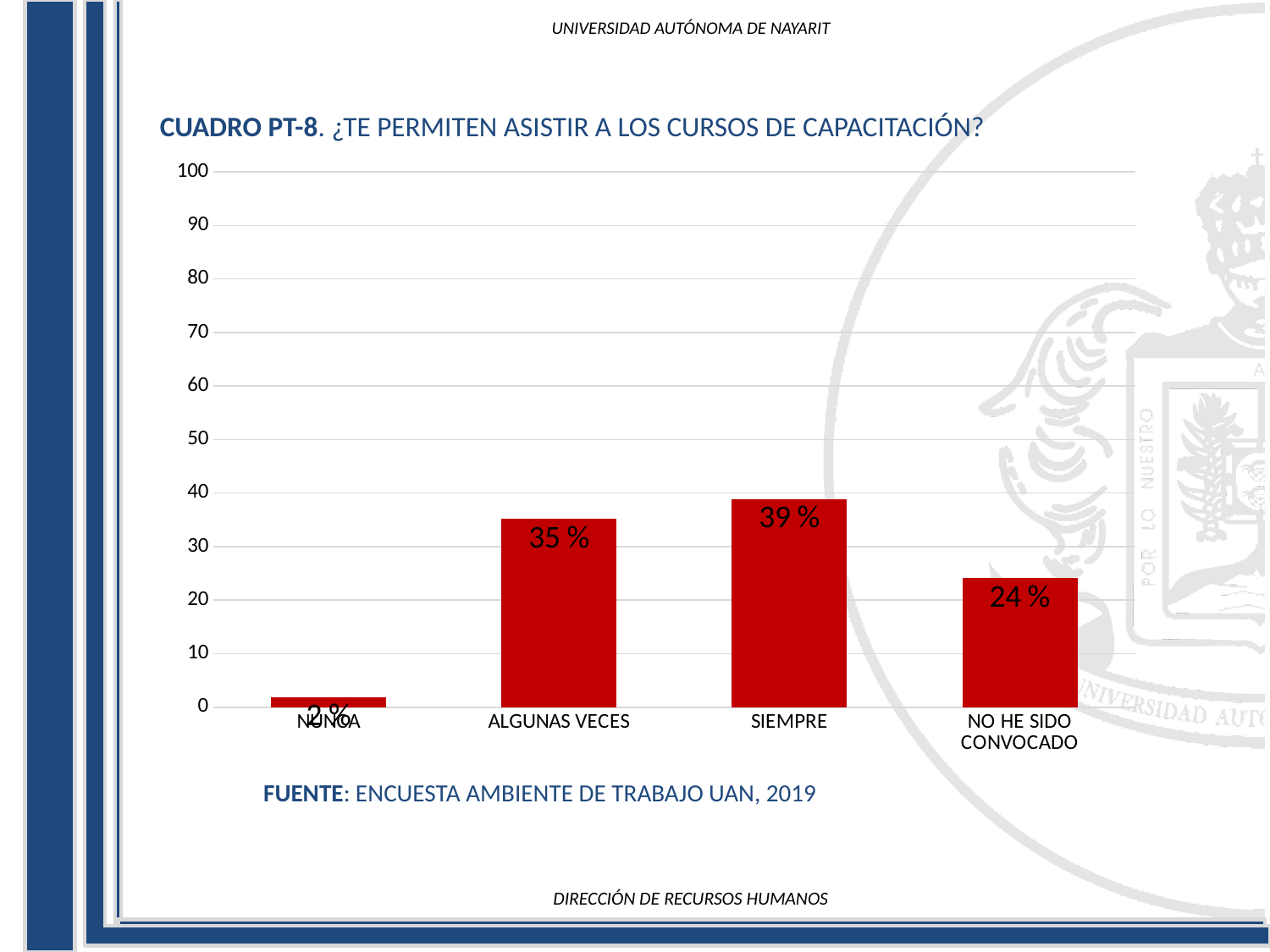
What is the value for ALGUNAS VECES? 35 % What kind of chart is shown on the slide? bar chart What is the difference between the values for ALGUNAS VECES and NO HE SIDO CONVOCADO? 11 % Which category has the highest value? SIEMPRE What is the value for NO HE SIDO CONVOCADO? 24 % What is the title of the chart? CUADRO PT-8. ¿TE PERMITEN ASISTIR A LOS CURSOS DE CAPACITACIÓN? What is the value for SIEMPRE? 39 % What is the difference between the values for SIEMPRE and ALGUNAS VECES? 4 % Which is larger, the value for ALGUNAS VECES or the value for NO HE SIDO CONVOCADO? ALGUNAS VECES Is the value for NO HE SIDO CONVOCADO greater or less than 30? less Which category has the lowest value? NUNCA How many categories are shown on the x axis? 4